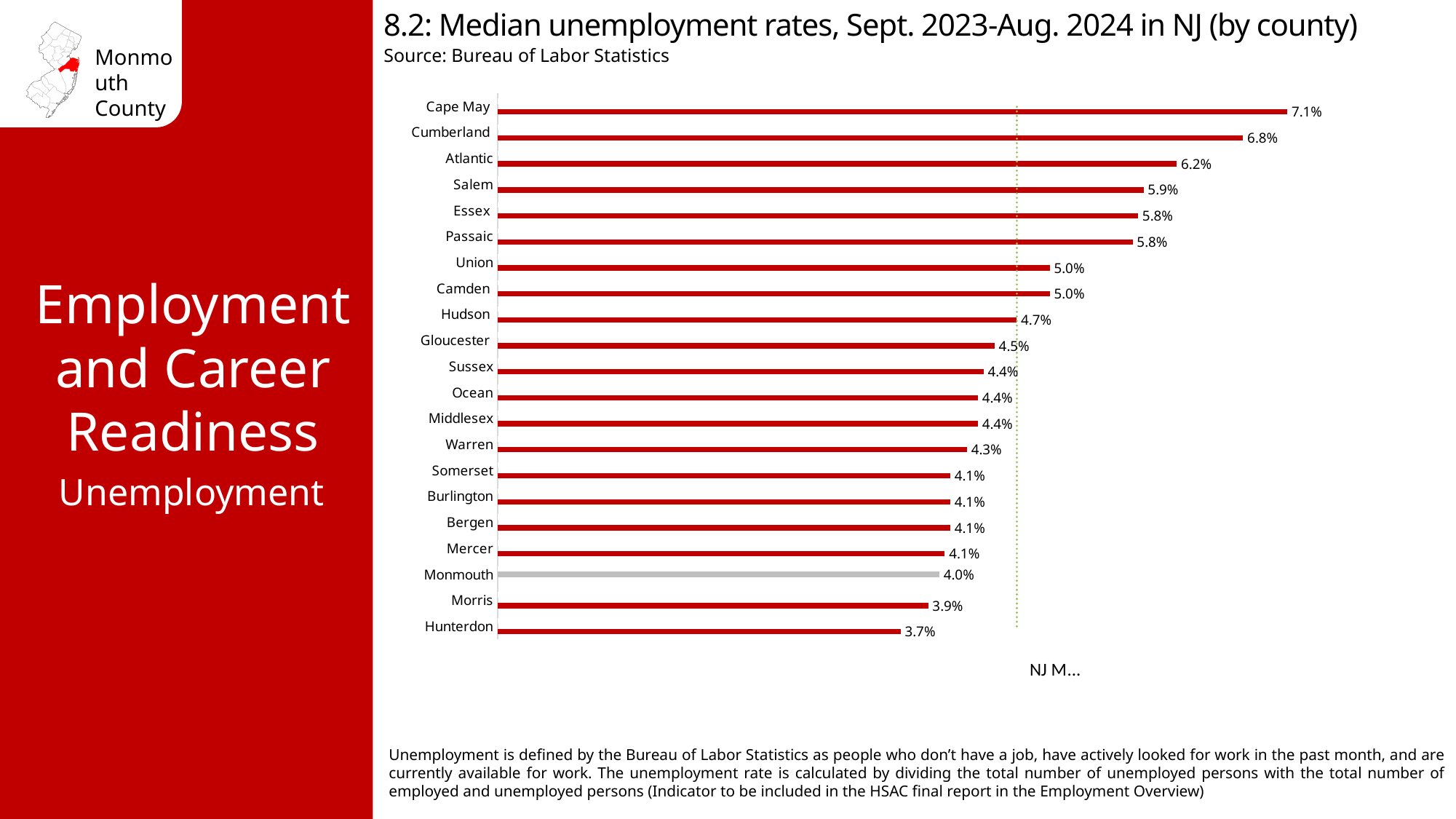
Which county has the lowest median unemployment rate? Hunterdon What is the median unemployment rate for Cape May? 7.1% What is the difference between the median unemployment rates of Cumberland and Monmouth? 2.8% Which county's bar is shown in grey instead of red? Monmouth How many counties are shown in the chart? 21 Which has a higher median unemployment rate, Morris or Warren? Warren What type of chart is used to show the median unemployment rates? Bar chart Which has a higher median unemployment rate, Atlantic or Salem? Atlantic What is the difference between the median unemployment rates of Cape May and Hunterdon? 3.4% What is the median unemployment rate for Monmouth County? 4.0% Which county has the highest median unemployment rate? Cape May What is the median unemployment rate for Hudson? 4.7%